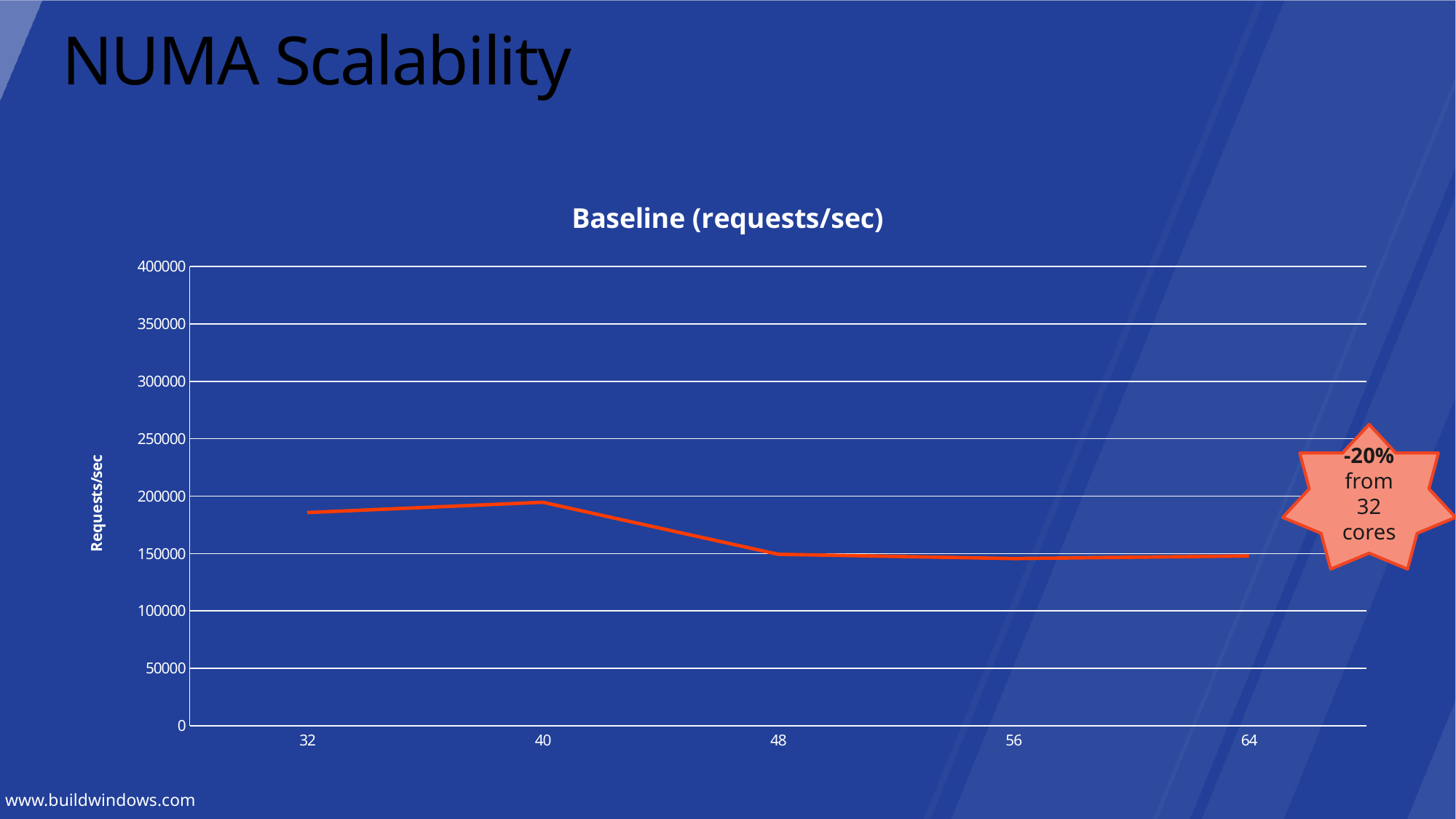
What is the title of the chart? Baseline (requests/sec) Does the line rise or fall between 40 and 48 on the x axis? fall At which x-axis value does the line reach its highest point? 40 Is the value at 64 greater or less than 100000? greater Is the value at 40 greater or less than 200000? less How many data points are plotted on the line? 5 Is the value at 56 greater or less than 200000? less What is the label on the vertical axis? Requests/sec Which has the larger value, 32 or 56? 32 What kind of chart is shown on the slide? line chart Which has the larger value, 40 or 48? 40